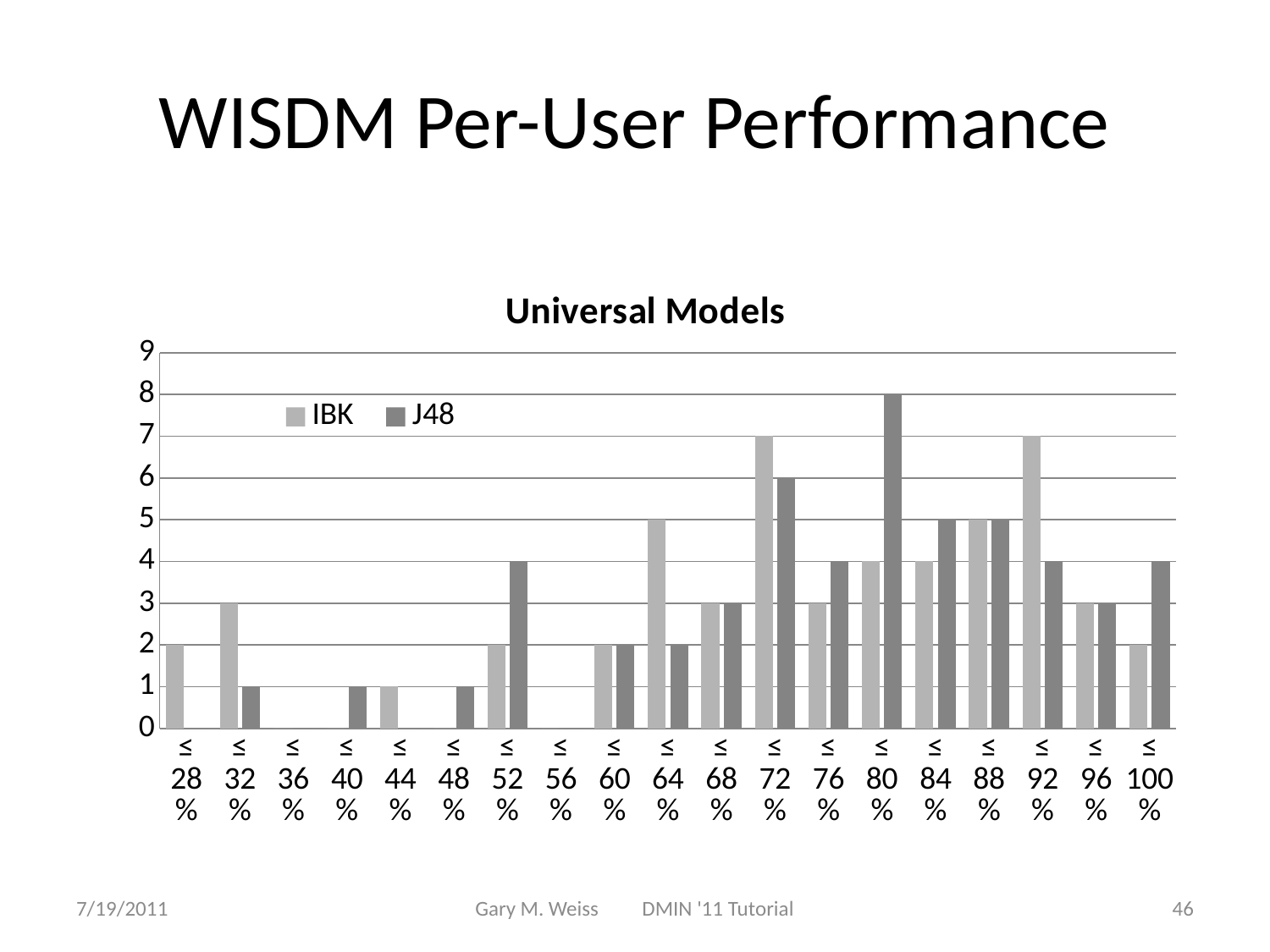
Which is larger for the ≤92% category, the IBK value or the J48 value? IBK What is the IBK value for the ≤72% category? 7 Is the J48 value for the ≤72% category greater or less than 5? greater What is the IBK value for the ≤64% category? 5 Which is larger for the ≤52% category, the IBK value or the J48 value? J48 What is the J48 value for the ≤80% category? 8 What is the difference between the J48 value and the IBK value for the ≤80% category? 4 How many series does the legend of the Universal Models chart list? 2 What is the title of the chart on the slide? Universal Models What type of chart is shown on the slide? bar chart How many categories are shown on the x axis of the Universal Models chart? 19 Which category has the highest J48 value? ≤80%